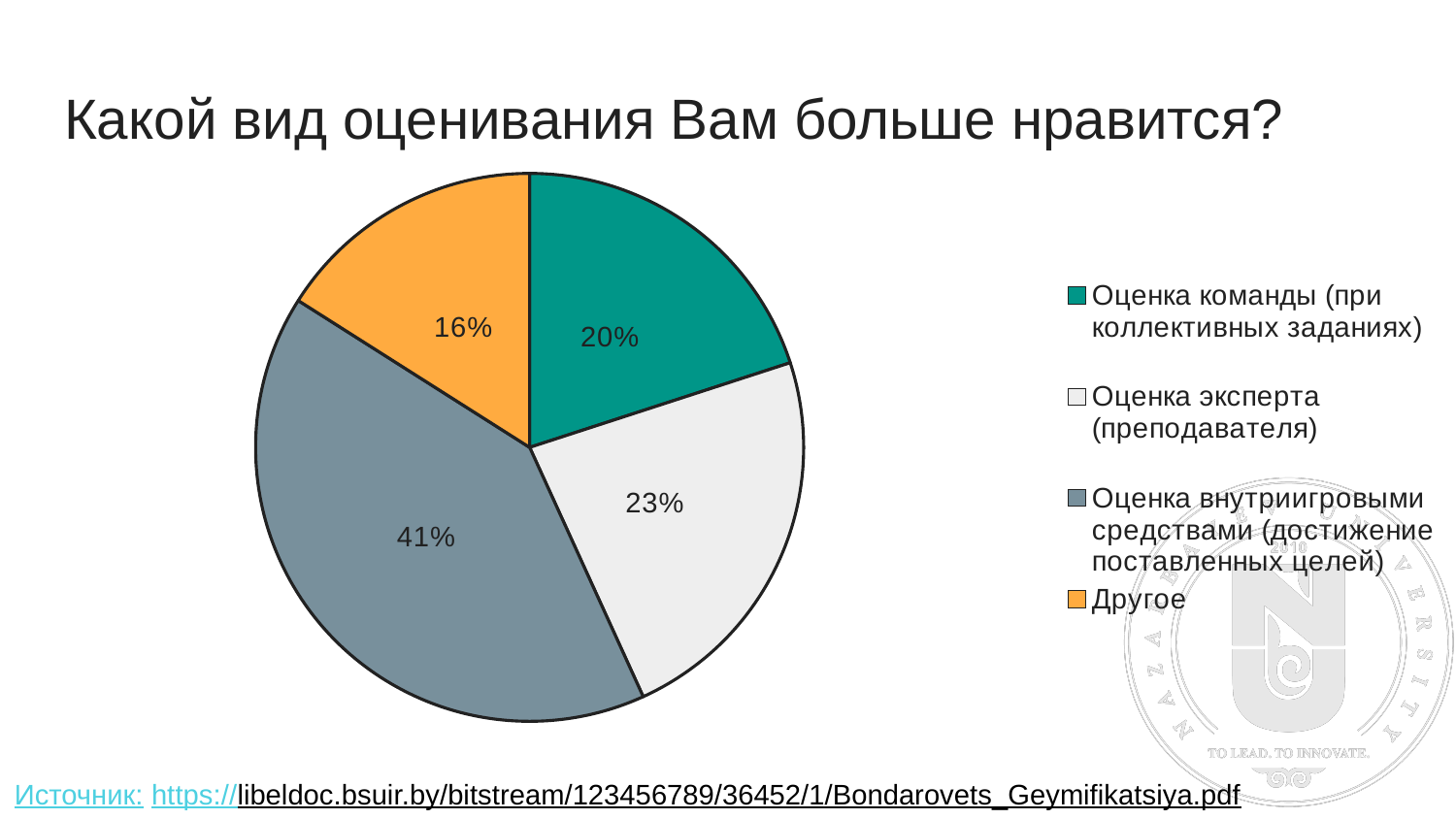
Which category has the largest slice of the pie? Оценка внутриигровыми средствами (достижение поставленных целей) What share of the pie is labelled "Оценка внутриигровыми средствами (достижение поставленных целей)"? 41% What share of the pie is labelled "Оценка эксперта (преподавателя)"? 23% What colour is the slice for "Другое"? orange What is the title of the chart? Какой вид оценивания Вам больше нравится? What type of chart is shown on the slide? pie chart How many categories does the legend list? 4 What is the difference in percentage points between "Оценка внутриигровыми средствами" and "Оценка эксперта (преподавателя)"? 18 Which category has the smallest slice of the pie? Другое What share of the pie is labelled "Другое"? 16% Which is larger: the slice for "Оценка эксперта (преподавателя)" or the slice for "Оценка команды (при коллективных заданиях)"? Оценка эксперта (преподавателя) What share of the pie is labelled "Оценка команды (при коллективных заданиях)"? 20%